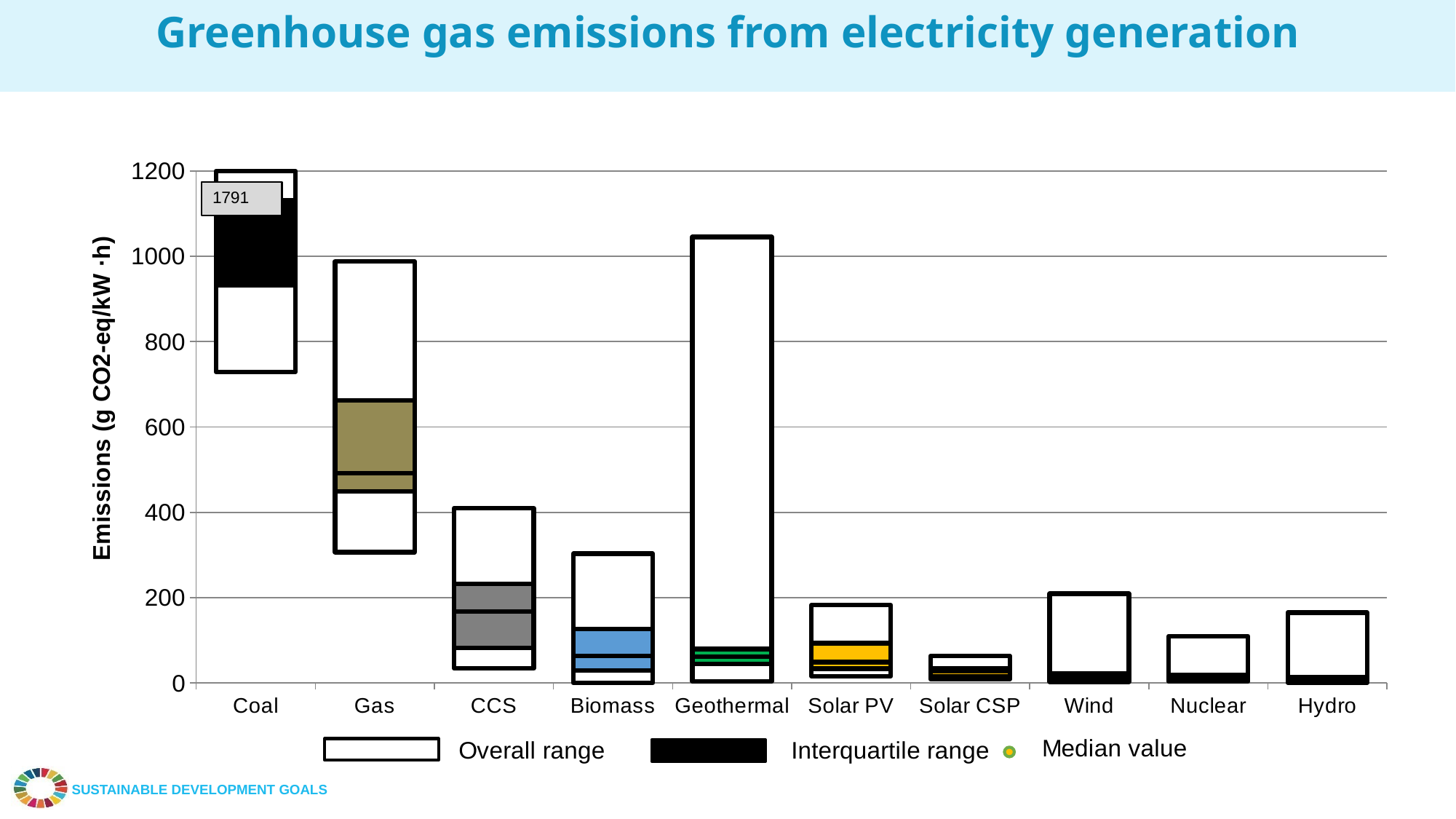
Is the upper end of the overall range for Nuclear greater or less than 200? less What is the label of the y axis? Emissions (g CO2-eq/kW ·h) Is the lower end of the overall range for Coal greater or less than 600? greater Which has a higher upper end of its overall range, Gas or CCS? Gas Which category has the highest upper end of its overall range? Coal What value is printed in the label at the top of the Coal bar? 1791 Which category has the lowest upper end of its overall range? Solar CSP What kind of chart is shown on the slide? Bar chart How many entries does the legend list? 3 What is the title of the chart? Greenhouse gas emissions from electricity generation Is the upper end of the overall range for Geothermal greater or less than 1000? greater How many electricity generation categories are shown on the x axis? 10